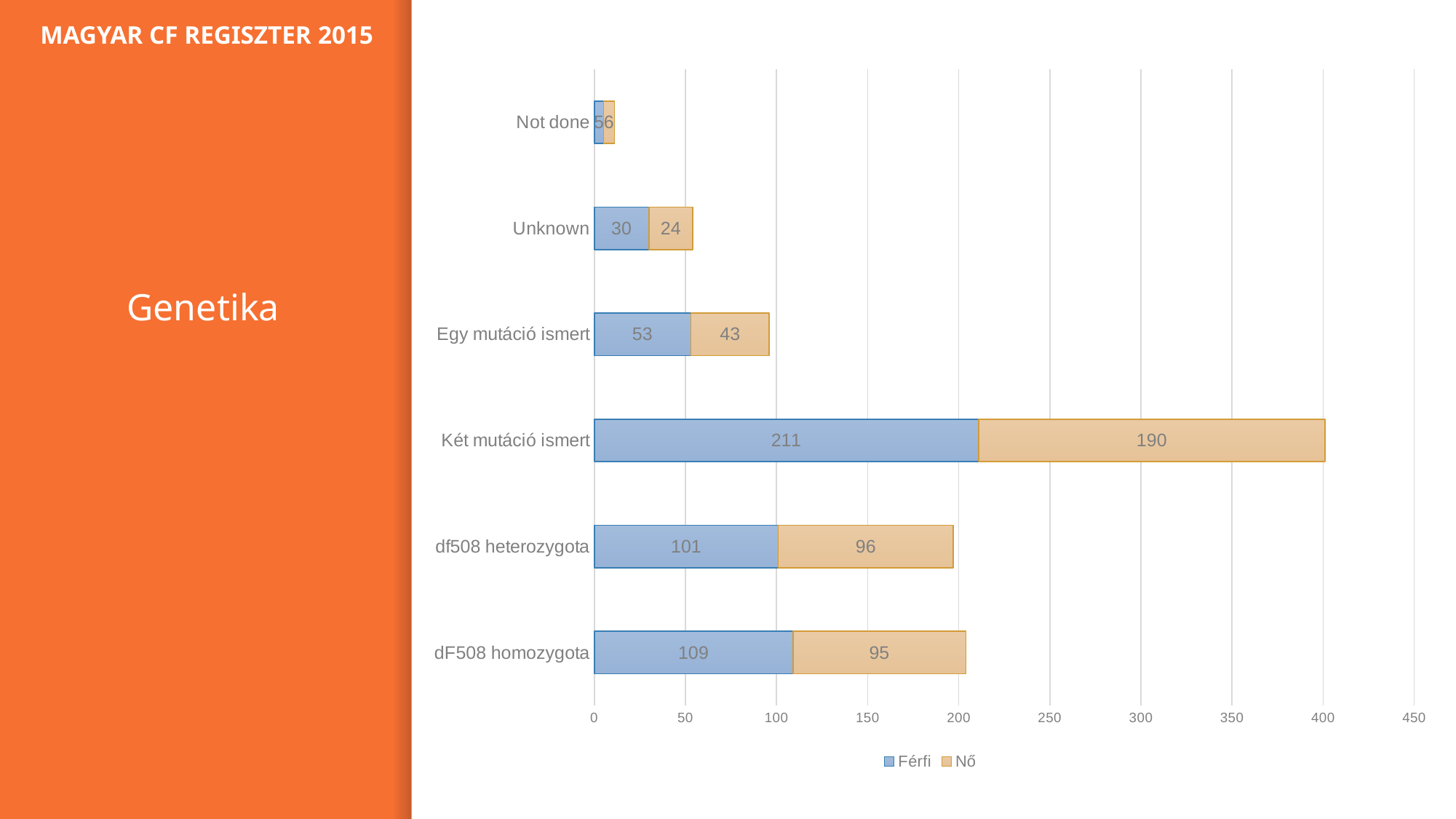
What is the Férfi value for Két mutáció ismert? 211 Which category has the lowest Nő value? Not done What is the difference between the Férfi and Nő values for dF508 homozygota? 14 Which category has the highest Férfi value? Két mutáció ismert What kind of chart is shown on the slide? Stacked bar chart What is the total of the stacked bar for Két mutáció ismert? 401 What is the Férfi value for Unknown? 30 What is the Nő value for df508 heterozygota? 96 How many categories are shown on the chart? 6 How many series does the legend list? 2 What is the Nő value for Egy mutáció ismert? 43 Which is larger, the Férfi value for dF508 homozygota or the Férfi value for df508 heterozygota? dF508 homozygota